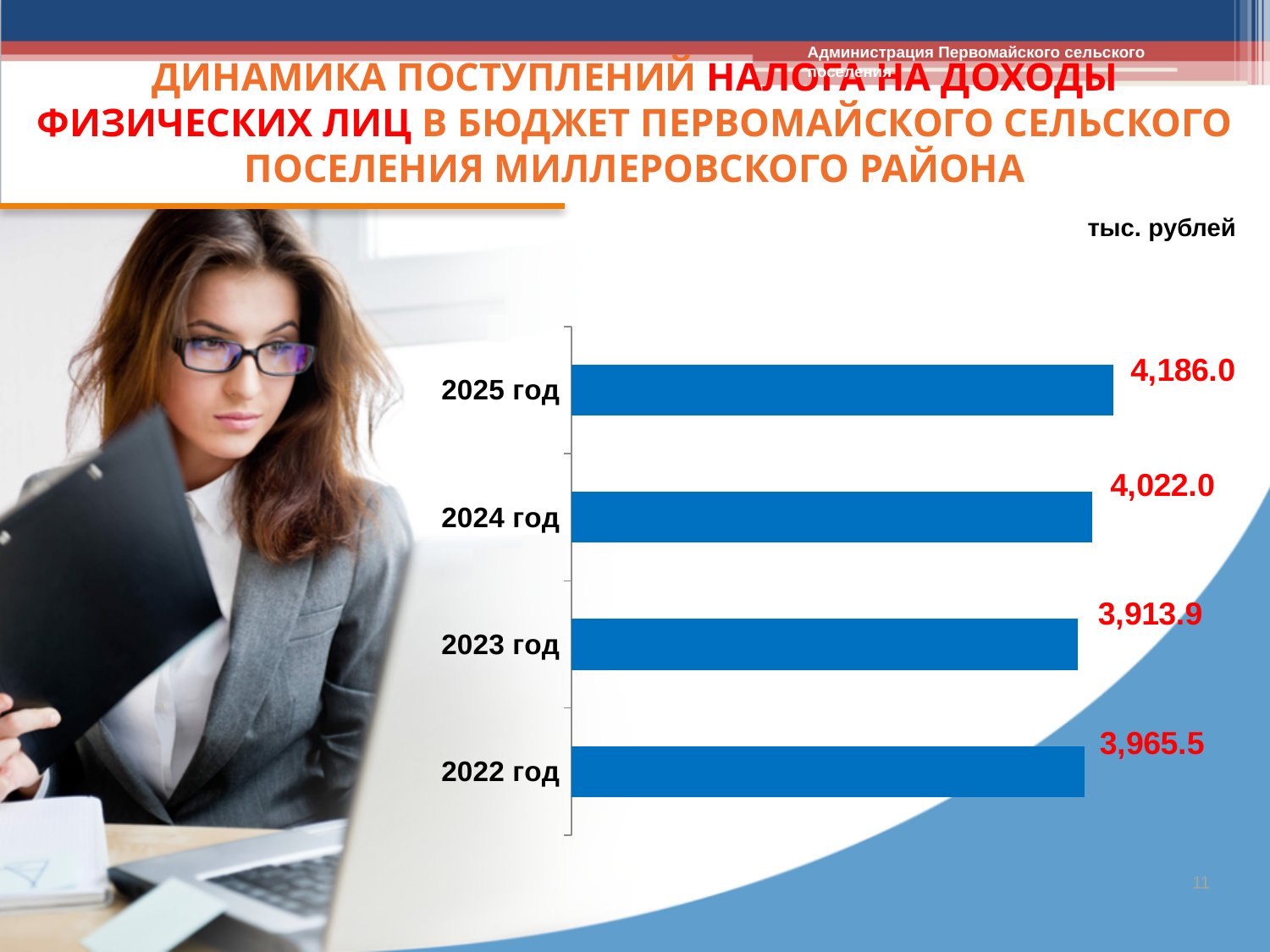
Which year has the lowest value? 2023 год What kind of chart is shown on the slide? Bar chart What is the difference between the values for 2025 год and 2024 год? 164.0 From 2023 год to 2025 год, do the values rise or fall? Rise How many years are shown in the chart? 4 Which is larger, the value for 2022 год or the value for 2023 год? 2022 год What is the value for 2025 год? 4,186.0 Which year has the highest value? 2025 год What is the value for 2023 год? 3,913.9 In what units are the chart values given? тыс. рублей What is the value for 2022 год? 3,965.5 What is the difference between the values for 2022 год and 2023 год? 51.6